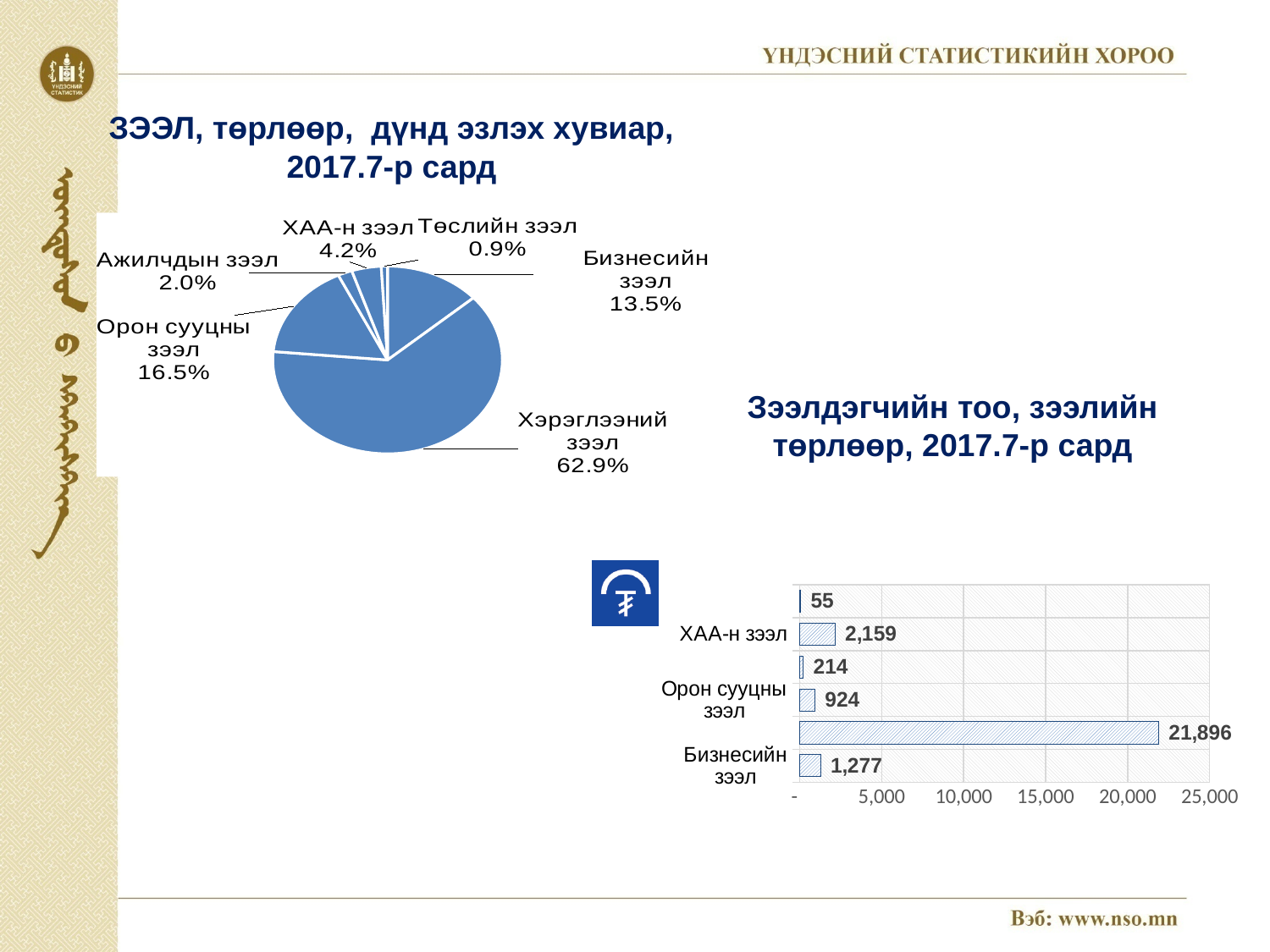
In the bar chart titled 'Зээлдэгчийн тоо, зээлийн төрлөөр, 2017.7-р сард', what is the value for ХАА-н зээл? 2,159 In the pie chart on the left, how many slices are there? 6 In the bar chart on the right, what is the value for Бизнесийн зээл? 1,277 In the pie chart on the left, which category has the smallest share? Төслийн зээл In the pie chart on the left, what is the value for Орон сууцны зээл? 16.5% In the pie chart titled 'ЗЭЭЛ, төрлөөр, дүнд эзлэх хувиар, 2017.7-р сард', what share does Хэрэглээний зээл have? 62.9% In the bar chart on the right, what is the value for Орон сууцны зээл? 924 In the pie chart on the left, which category has the largest share? Хэрэглээний зээл What type of chart is the chart on the right of the slide? Bar chart In the pie chart on the left, what is the value for Бизнесийн зээл? 13.5% In the pie chart on the left, what is the difference between the shares of ХАА-н зээл and Ажилчдын зээл? 2.2 percentage points In the pie chart on the left, which is larger: Орон сууцны зээл or Бизнесийн зээл? Орон сууцны зээл